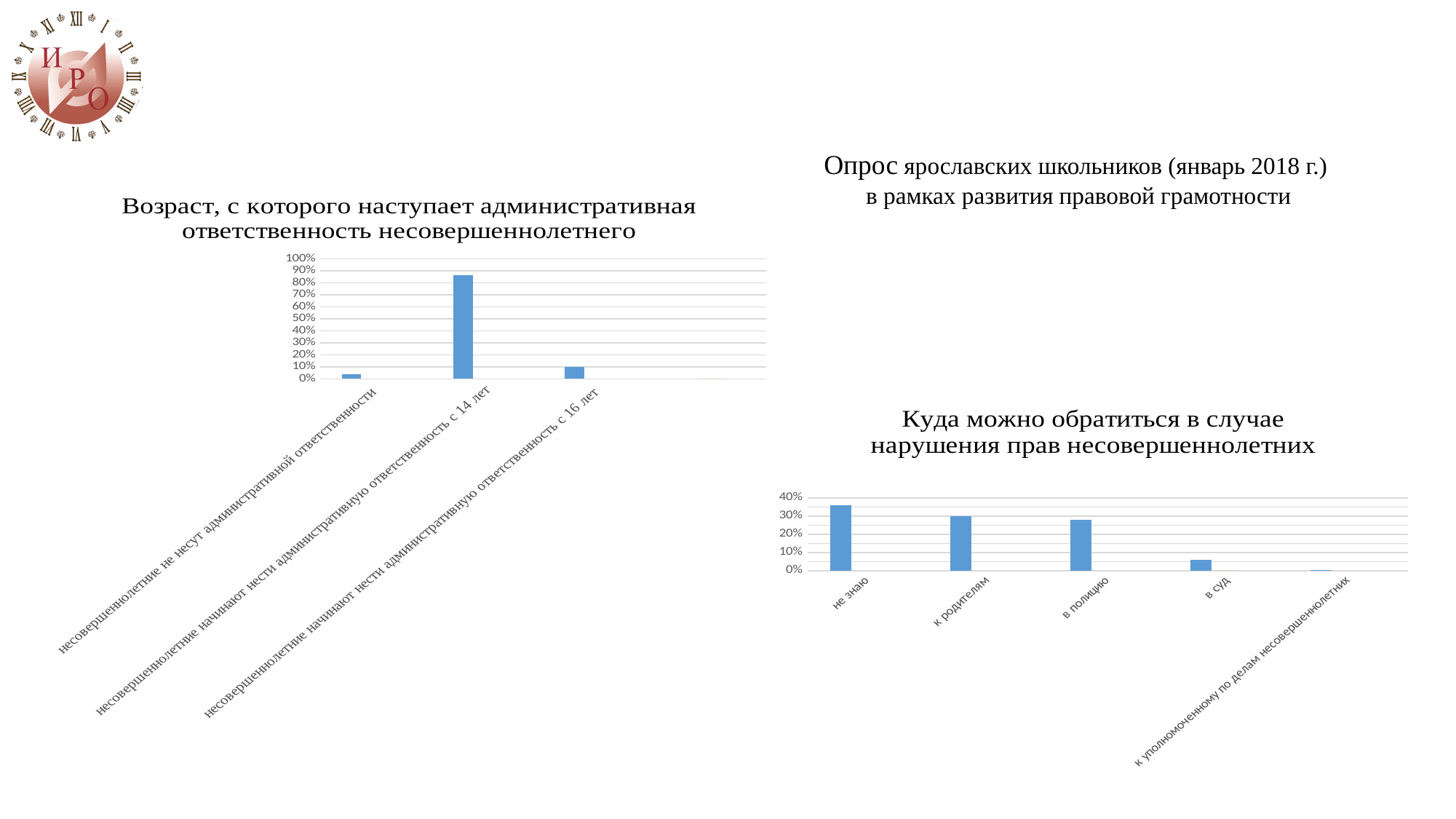
On the chart titled "Возраст, с которого наступает административная ответственность несовершеннолетнего", how many categories are shown? 3 On the chart titled "Куда можно обратиться в случае нарушения прав несовершеннолетних", which category has the lowest value? к уполномоченному по делам несовершеннолетних On the chart titled "Возраст, с которого наступает административная ответственность несовершеннолетнего", which category has the highest value? несовершеннолетние начинают нести административную ответственность с 14 лет On the chart titled "Возраст, с которого наступает административная ответственность несовершеннолетнего", is the value for "несовершеннолетние начинают нести административную ответственность с 16 лет" greater or less than 20%? less On the chart titled "Куда можно обратиться в случае нарушения прав несовершеннолетних", which is larger: the value for "не знаю" or the value for "в суд"? не знаю On the chart titled "Возраст, с которого наступает административная ответственность несовершеннолетнего", is the value for "несовершеннолетние начинают нести административную ответственность с 14 лет" greater or less than 80%? greater On the chart titled "Куда можно обратиться в случае нарушения прав несовершеннолетних", is the value for "в суд" greater or less than 10%? less On the chart titled "Куда можно обратиться в случае нарушения прав несовершеннолетних", which category has the highest value? не знаю On the chart titled "Возраст, с которого наступает административная ответственность несовершеннолетнего", which category has the lowest value? несовершеннолетние не несут административной ответственности On the chart titled "Куда можно обратиться в случае нарушения прав несовершеннолетних", how many categories are shown? 5 What type of chart is the one titled "Возраст, с которого наступает административная ответственность несовершеннолетнего"? bar chart